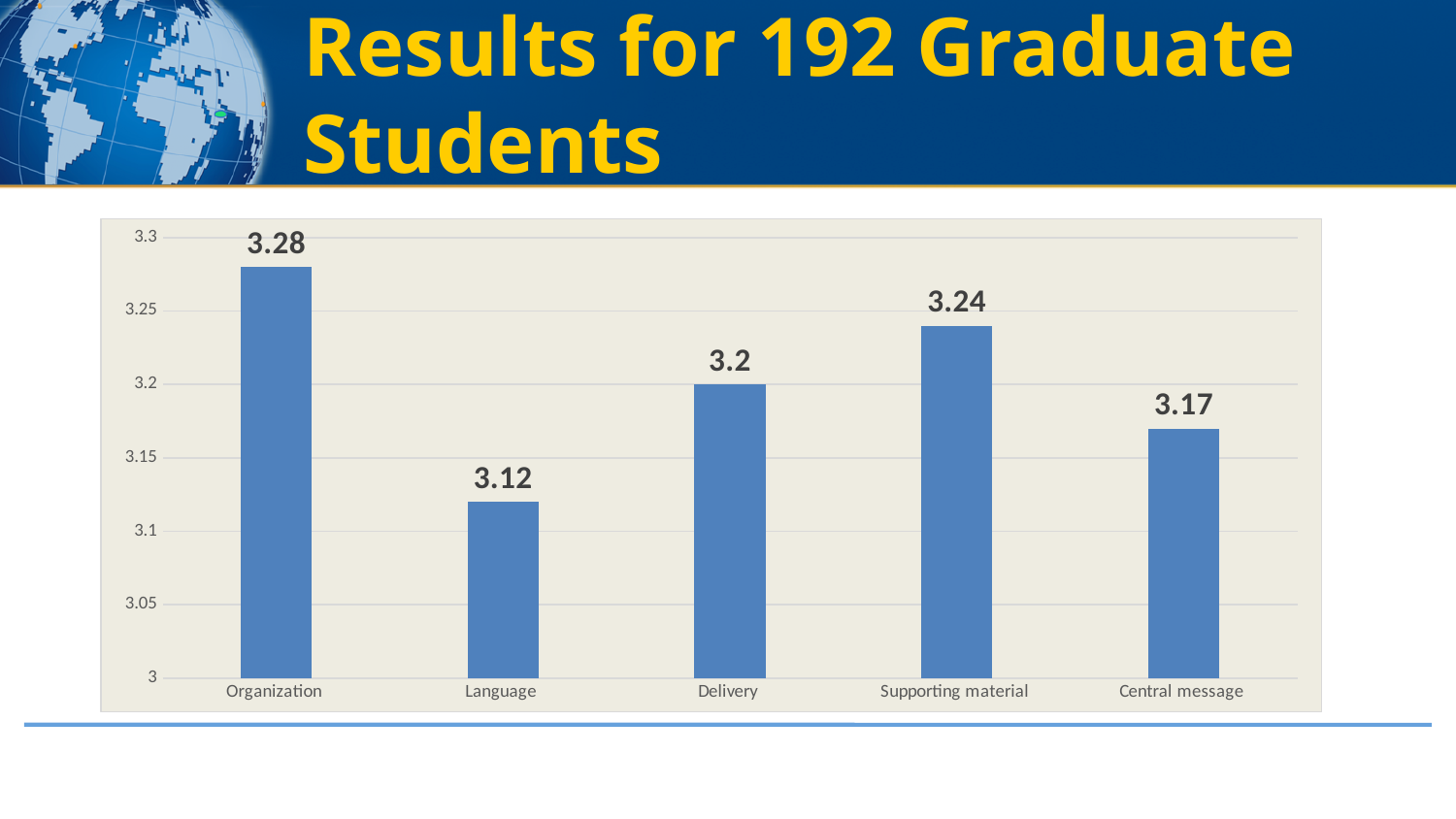
What is the value for Organization? 3.28 What is the value for Delivery? 3.2 What kind of chart is shown on the slide? bar chart How many categories are shown on the x axis? 5 What is the value for Language? 3.12 Which category has the lowest value? Language What is the value for Supporting material? 3.24 What is the value for Central message? 3.17 Is the value for Delivery greater or less than 3.15? greater Which category has the highest value? Organization What is the difference between the values for Organization and Language? 0.16 Which is larger, the value for Supporting material or the value for Central message? Supporting material